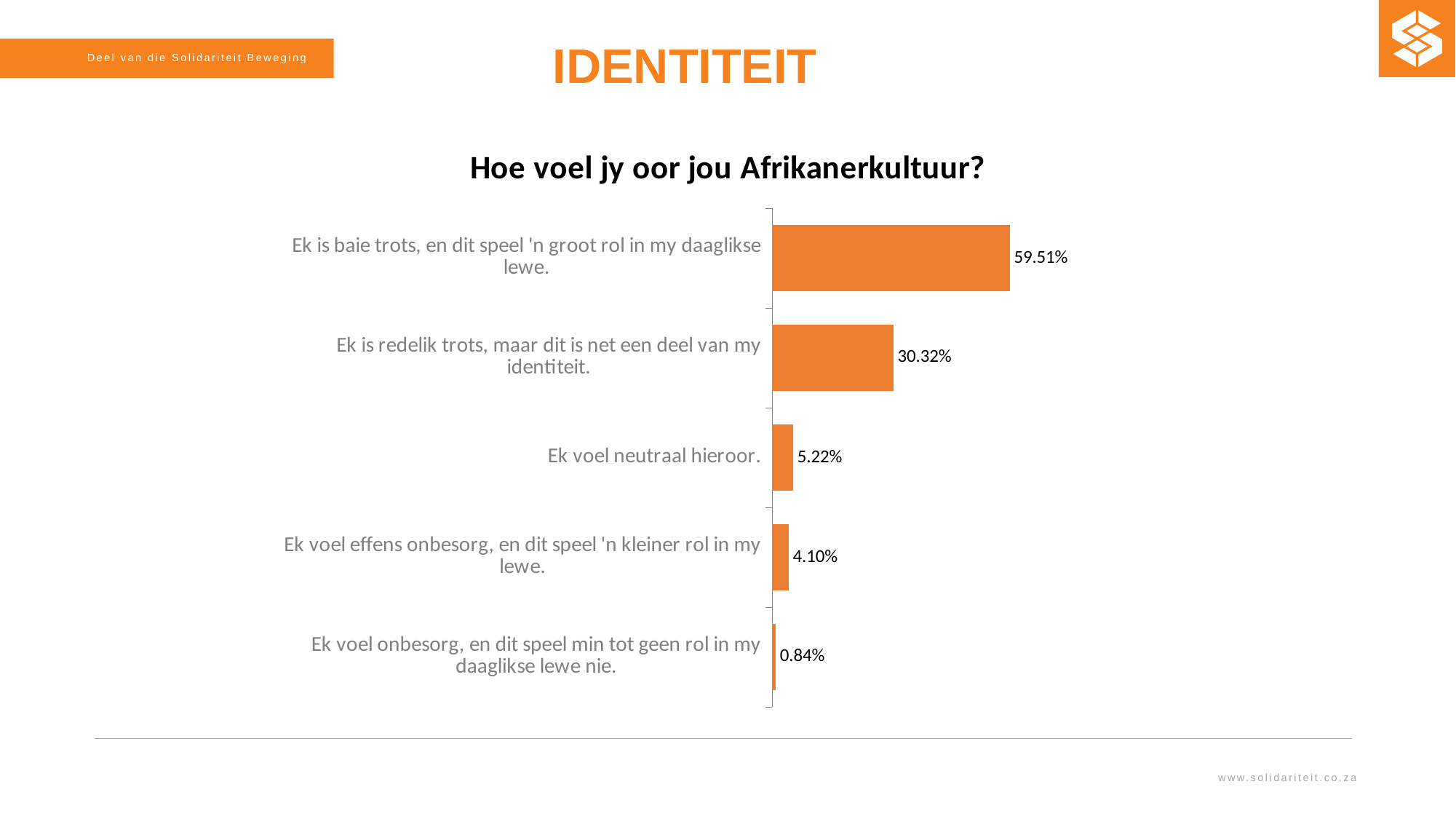
What is the difference between the values for "Ek is baie trots, en dit speel 'n groot rol in my daaglikse lewe." and "Ek is redelik trots, maar dit is net een deel van my identiteit."? 29.19% What is the value for "Ek voel neutraal hieroor."? 5.22% What is the value for "Ek voel effens onbesorg, en dit speel 'n kleiner rol in my lewe."? 4.10% What is the title of the chart? Hoe voel jy oor jou Afrikanerkultuur? What is the value for "Ek is redelik trots, maar dit is net een deel van my identiteit."? 30.32% How many categories are shown in the chart? 5 Which category has the highest value? Ek is baie trots, en dit speel 'n groot rol in my daaglikse lewe. What is the value for "Ek voel onbesorg, en dit speel min tot geen rol in my daaglikse lewe nie."? 0.84% Which is larger: the value for "Ek voel neutraal hieroor." or the value for "Ek voel effens onbesorg, en dit speel 'n kleiner rol in my lewe."? Ek voel neutraal hieroor. What kind of chart is shown on the slide? Bar chart Which category has the lowest value? Ek voel onbesorg, en dit speel min tot geen rol in my daaglikse lewe nie. What is the value for "Ek is baie trots, en dit speel 'n groot rol in my daaglikse lewe."? 59.51%